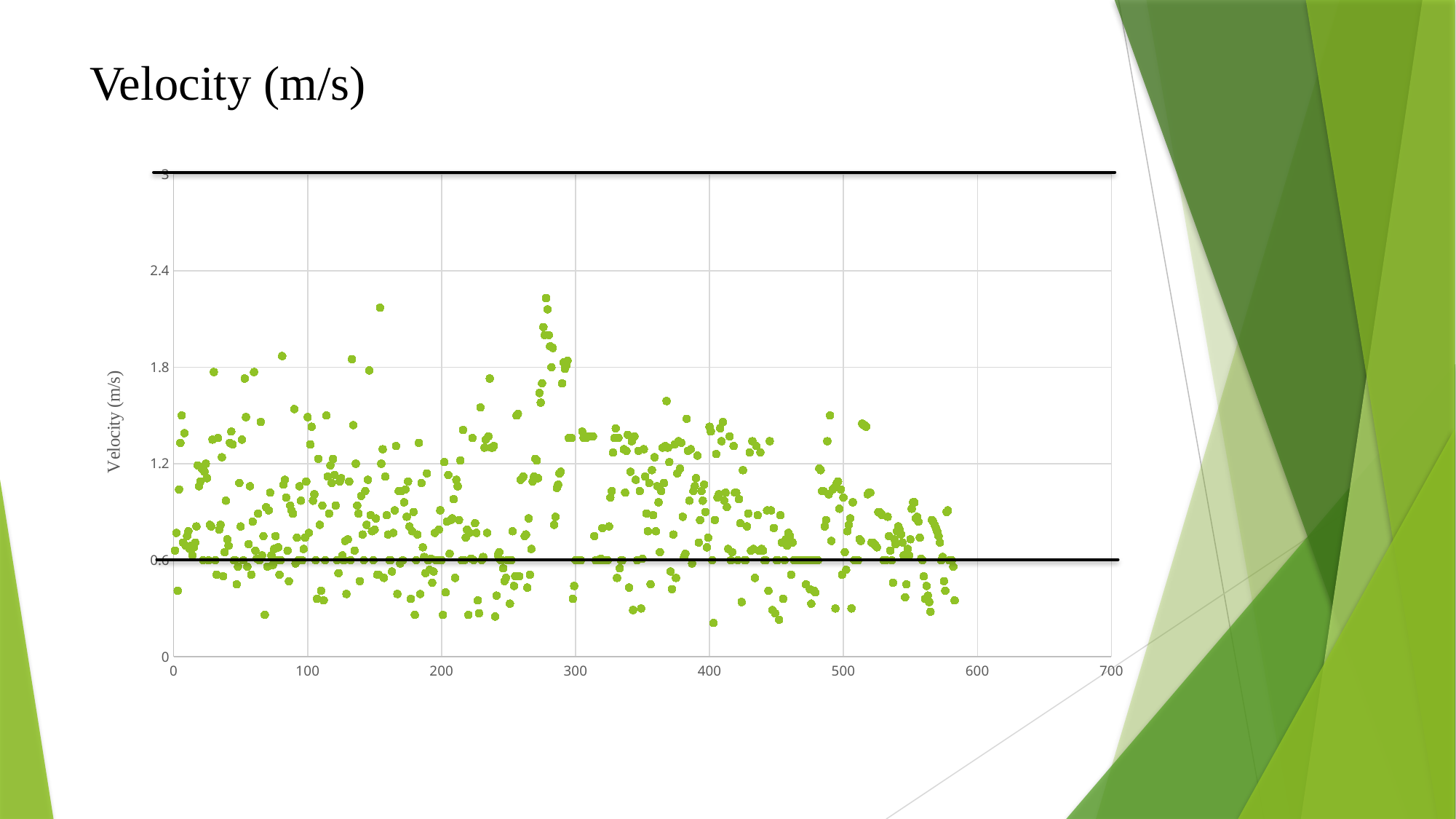
What is the title of the chart on the slide? Velocity (m/s) At what y-axis value is the lower horizontal black line drawn on the chart? 0.6 What is the label on the vertical axis of the chart? Velocity (m/s) Is the lowest plotted point on the chart greater or less than 0.6? less Is the highest plotted point on the chart greater or less than 2.4? less What kind of chart is shown on the slide? scatter chart